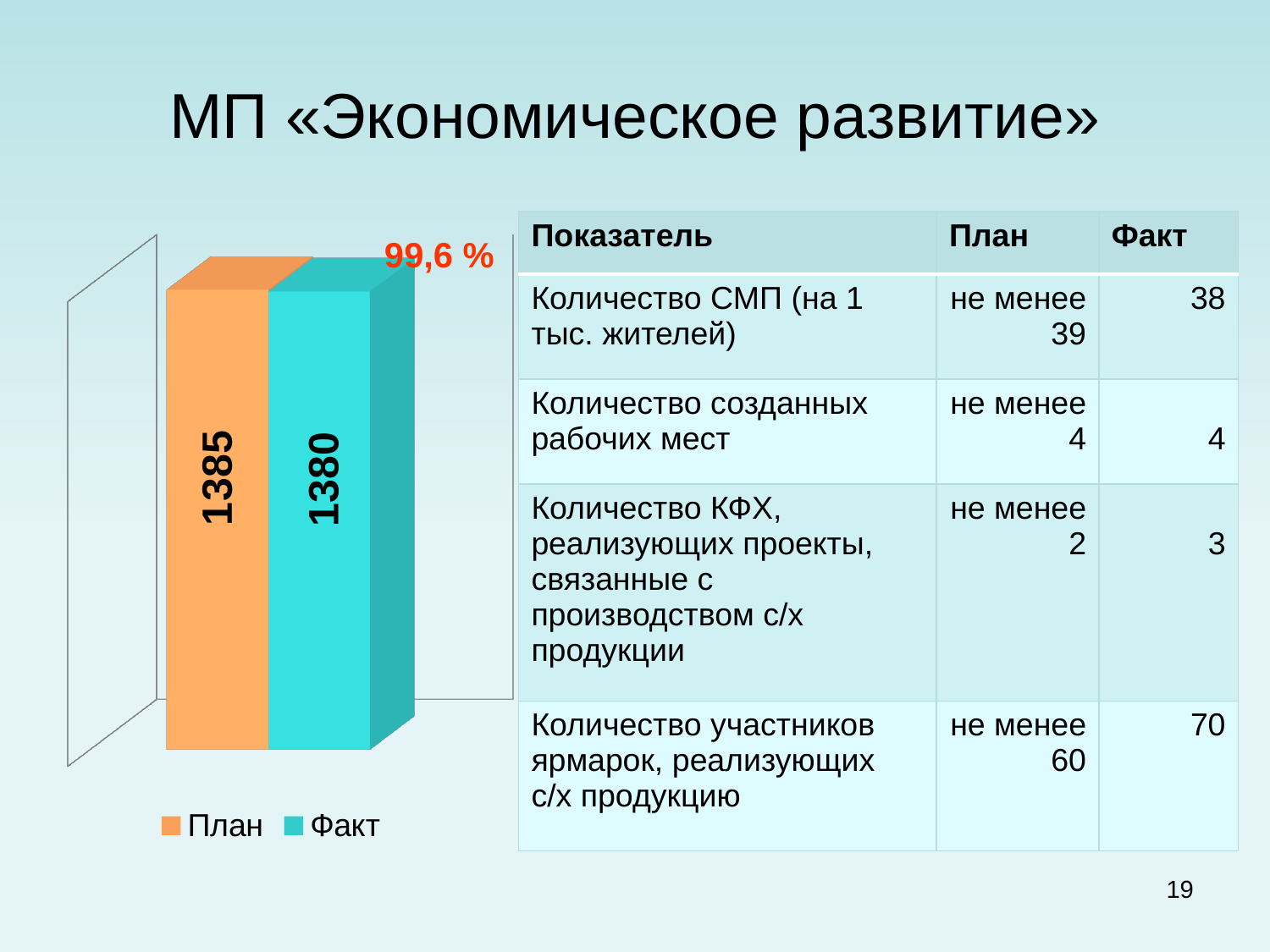
How many series does the chart legend list? 2 What is the value of the План bar in the chart? 1385 What kind of chart is shown on the slide? bar chart Which series has the lowest value in the chart? Факт What colour is the Факт bar in the chart? teal What is the difference between the План and Факт values in the chart? 5 Which bar is taller in the chart, План or Факт? План What percentage is printed above the bars in the chart? 99,6 % How many bars are plotted in the chart? 2 What is the value of the Факт bar in the chart? 1380